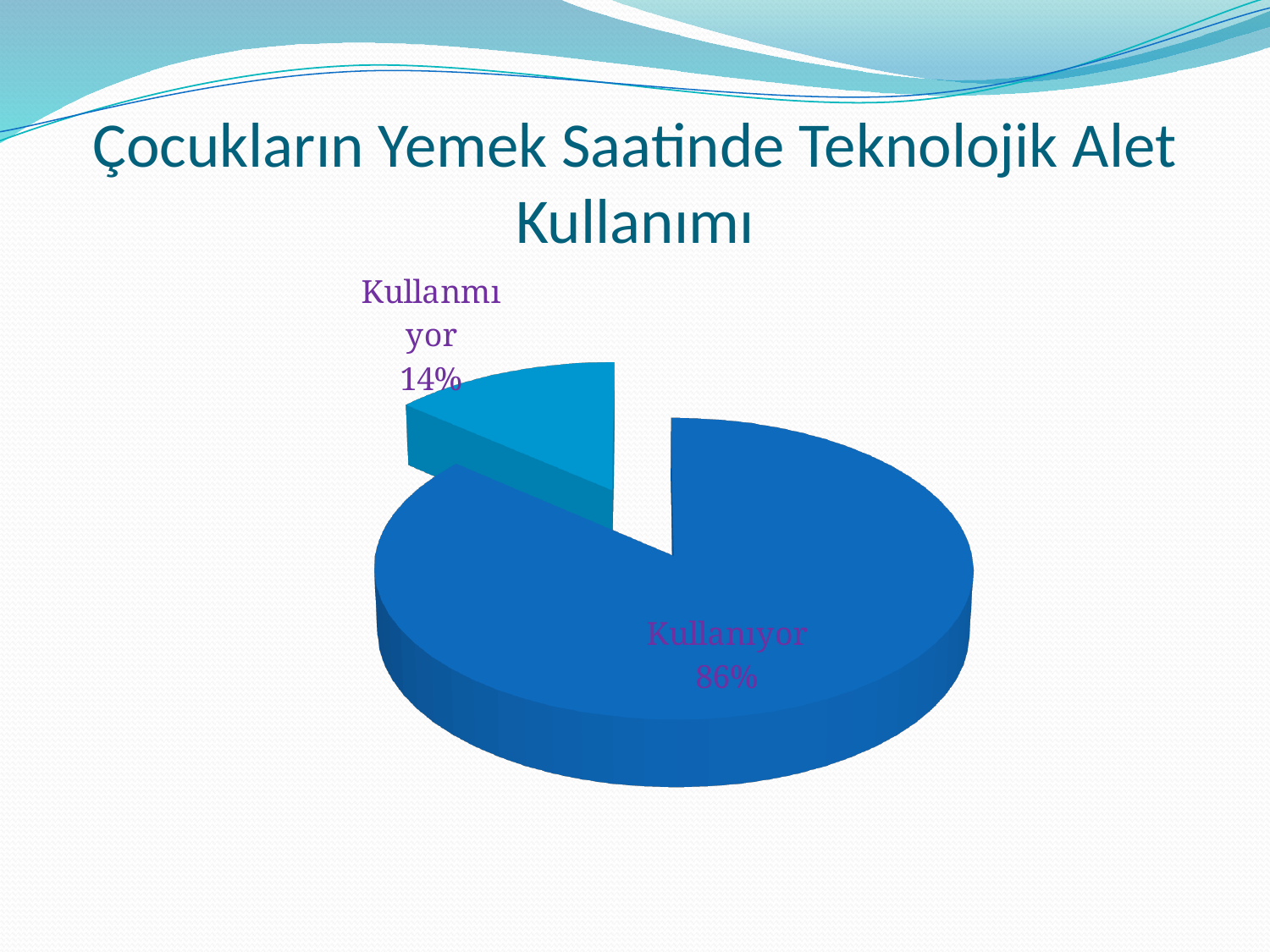
Which slice is pulled out (exploded) from the rest of the pie? Kullanmıyor What kind of chart is shown on the slide? Pie chart Which slice of the pie is the smallest? Kullanmıyor How many slices does the pie chart have? 2 What is the title of the slide containing the chart? Çocukların Yemek Saatinde Teknolojik Alet Kullanımı What is the difference in percentage points between the "Kullanıyor" and "Kullanmıyor" slices? 72 Which is larger, the "Kullanıyor" slice or the "Kullanmıyor" slice? Kullanıyor Which slice of the pie is the largest? Kullanıyor What share of the pie does the "Kullanmıyor" slice represent? 14% What share of the pie does the "Kullanıyor" slice represent? 86%